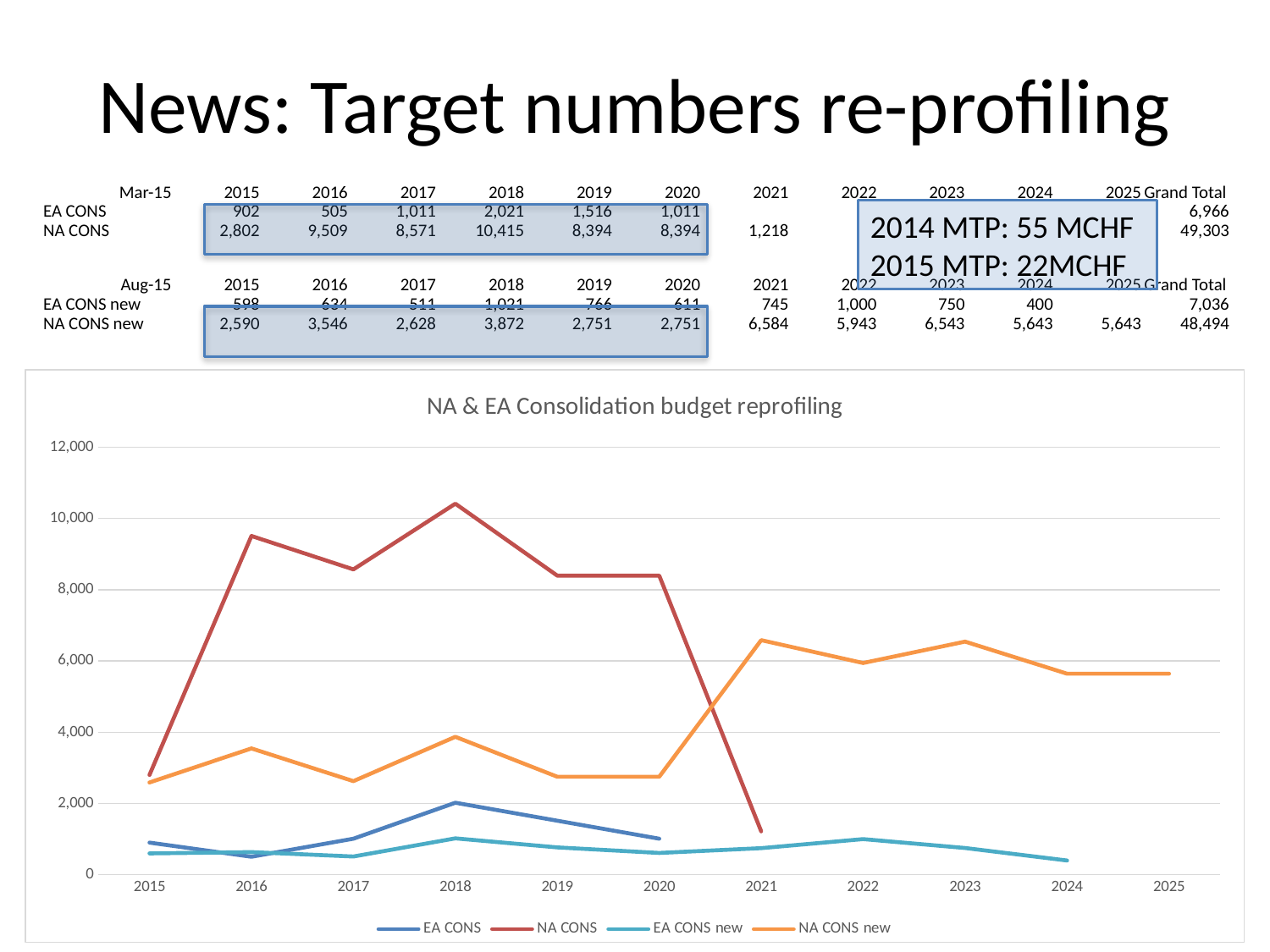
Is the NA CONS new value for 2021 greater or less than 6,000? greater In 2021, which series is larger: NA CONS or NA CONS new? NA CONS new In which year does the NA CONS series reach its highest value? 2018 What is the NA CONS new value for 2025? 5,643 How many series does the chart legend list? 4 How many years are shown along the x axis of the chart? 11 What is the NA CONS value for 2018? 10,415 In which year does the NA CONS series reach its lowest value? 2021 What is the title of the chart? NA & EA Consolidation budget reprofiling Does the NA CONS series rise or fall between 2018 and 2021? fall Is the NA CONS value for 2016 greater or less than 8,000? greater What kind of chart is shown on the slide? line chart